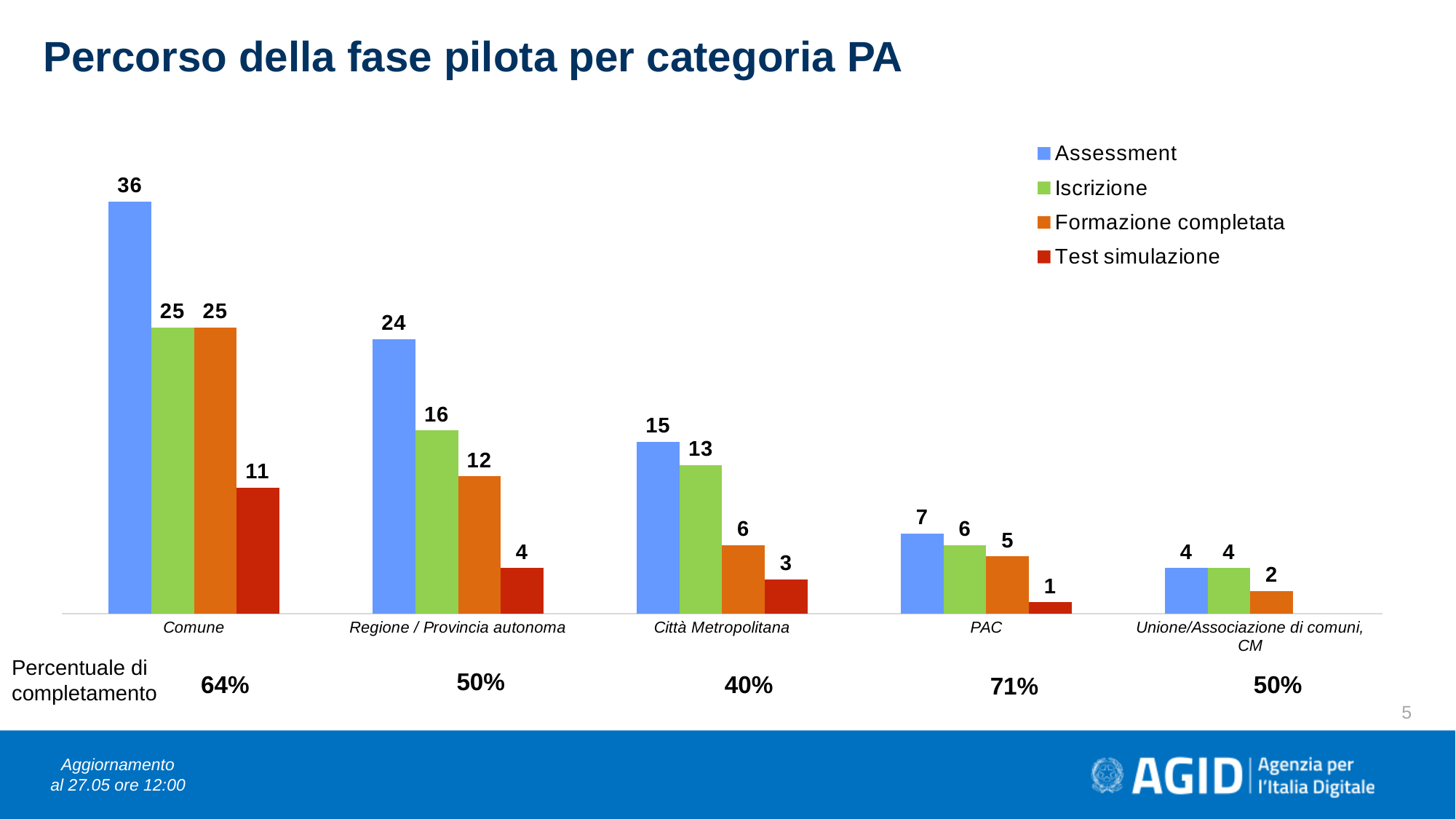
What is the Test simulazione value for Regione / Provincia autonoma? 4 How many categories are shown on the x axis? 5 Which is larger for Città Metropolitana: the Assessment value or the Iscrizione value? Assessment Which category has the highest Assessment value? Comune What is the difference between the Assessment and Iscrizione values for Regione / Provincia autonoma? 8 How many series does the legend list? 4 What is the Formazione completata value for Città Metropolitana? 6 What is the Iscrizione value for PAC? 6 What kind of chart is shown on the slide? Bar chart What is the Assessment value for Comune? 36 Does the Assessment value rise or fall from Comune to Unione/Associazione di comuni, CM? Fall Which category has the lowest Test simulazione value? PAC